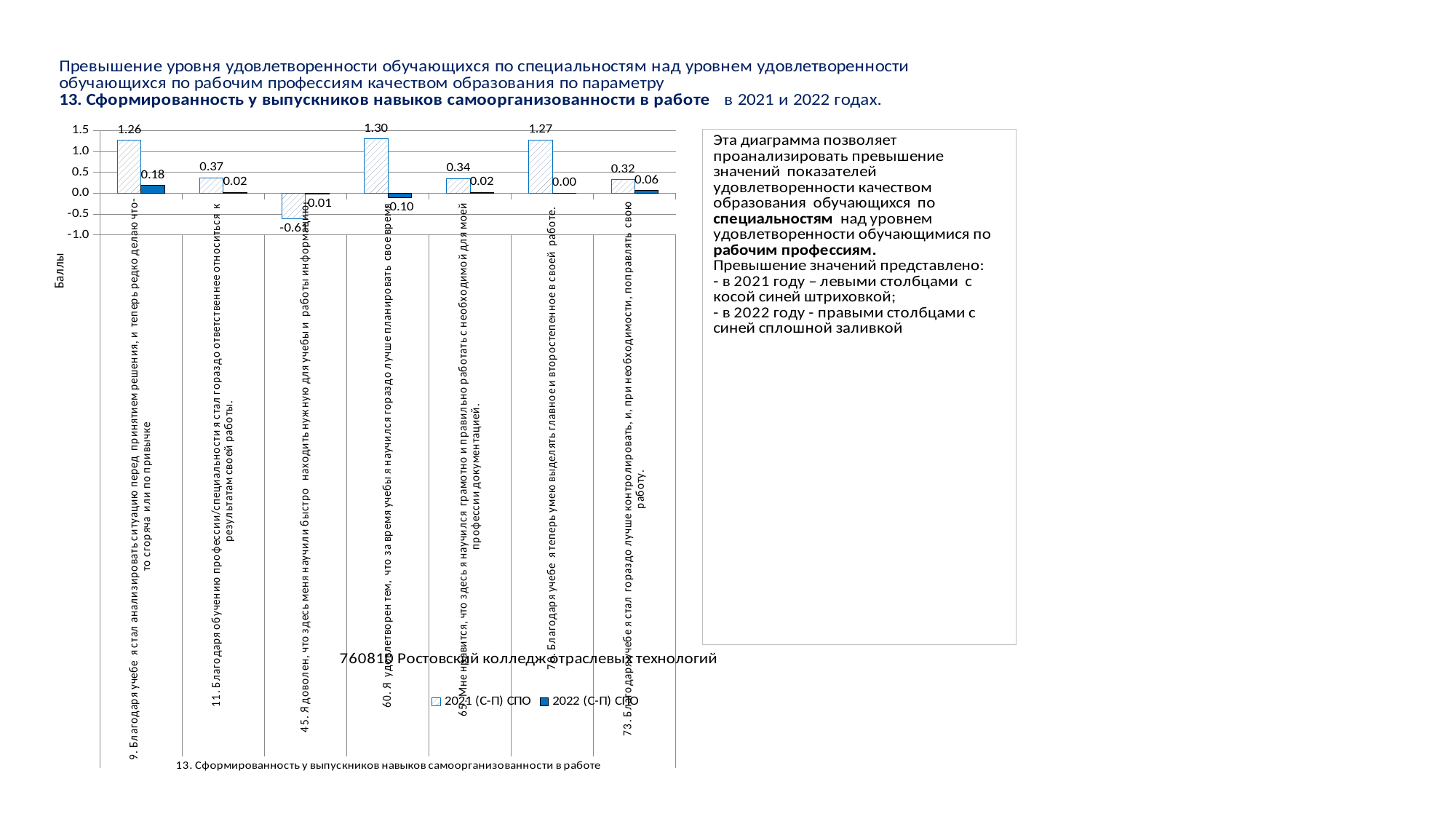
What type of chart is shown on the slide? bar chart Which series is shown with a diagonal hatched fill in the chart? 2021 (С-П) СПО What is the difference between the 2021 and 2022 (С-П) СПО values for statement 73 ("Благодаря учебе я стал гораздо лучше контролировать... свою работу")? 0.26 Which statement has the highest 2021 (С-П) СПО value? 60. Я удовлетворен тем, что за время учебы я научился гораздо лучше планировать свое время For statement 11 ("Благодаря обучению профессии/специальности я стал гораздо ответственнее..."), which is larger: the 2021 value or the 2022 value? 2021 (С-П) СПО How many categories (statements) are plotted on the chart? 7 Which statement has the lowest 2022 (С-П) СПО value? 60. Я удовлетворен тем, что за время учебы я научился гораздо лучше планировать свое время How many series does the chart legend list? 2 What is the 2022 (С-П) СПО value for statement 70 ("Благодаря учебе я теперь умею выделять главное и второстепенное в своей работе")? 0.00 What is the 2021 (С-П) СПО value for statement 60 ("Я удовлетворен тем, что за время учебы я научился гораздо лучше планировать свое время")? 1.30 What is the 2021 (С-П) СПО value for statement 9 ("Благодаря учебе я стал анализировать ситуацию...")? 1.26 What is the 2022 (С-П) СПО value for statement 9 ("Благодаря учебе я стал анализировать ситуацию...")? 0.18